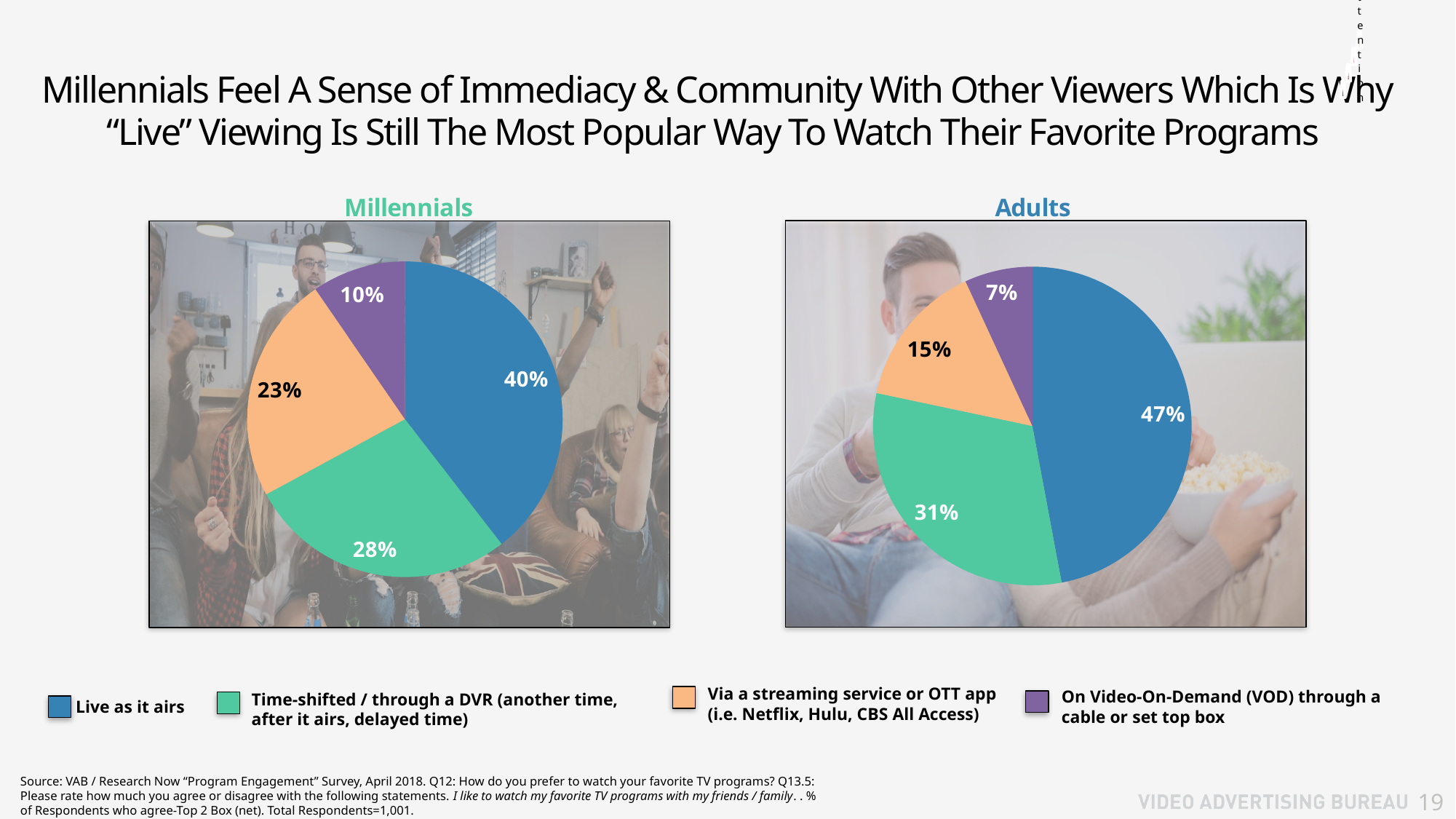
In the Millennials pie chart, what is the difference between the "Time-shifted / through a DVR" share and the "Via a streaming service or OTT app" share? 5% In the Millennials pie chart, what percentage is shown for "Via a streaming service or OTT app"? 23% In the Adults pie chart, what percentage is shown for "On Video-On-Demand (VOD) through a cable or set top box"? 7% What is the difference between the "Live as it airs" share for Adults and for Millennials? 7% In the Adults pie chart, what percentage is shown for "Time-shifted / through a DVR"? 31% How many slices does the Adults pie chart have? 4 What colour represents "Live as it airs" in the legend? Blue In the Millennials pie chart, what percentage is shown for "Live as it airs"? 40% In the Adults pie chart, which category has the smallest share? On Video-On-Demand (VOD) through a cable or set top box What type of chart is used to show the Millennials data? Pie chart Which group has a larger share for "Via a streaming service or OTT app", Millennials or Adults? Millennials In the Millennials pie chart, which category has the largest share? Live as it airs